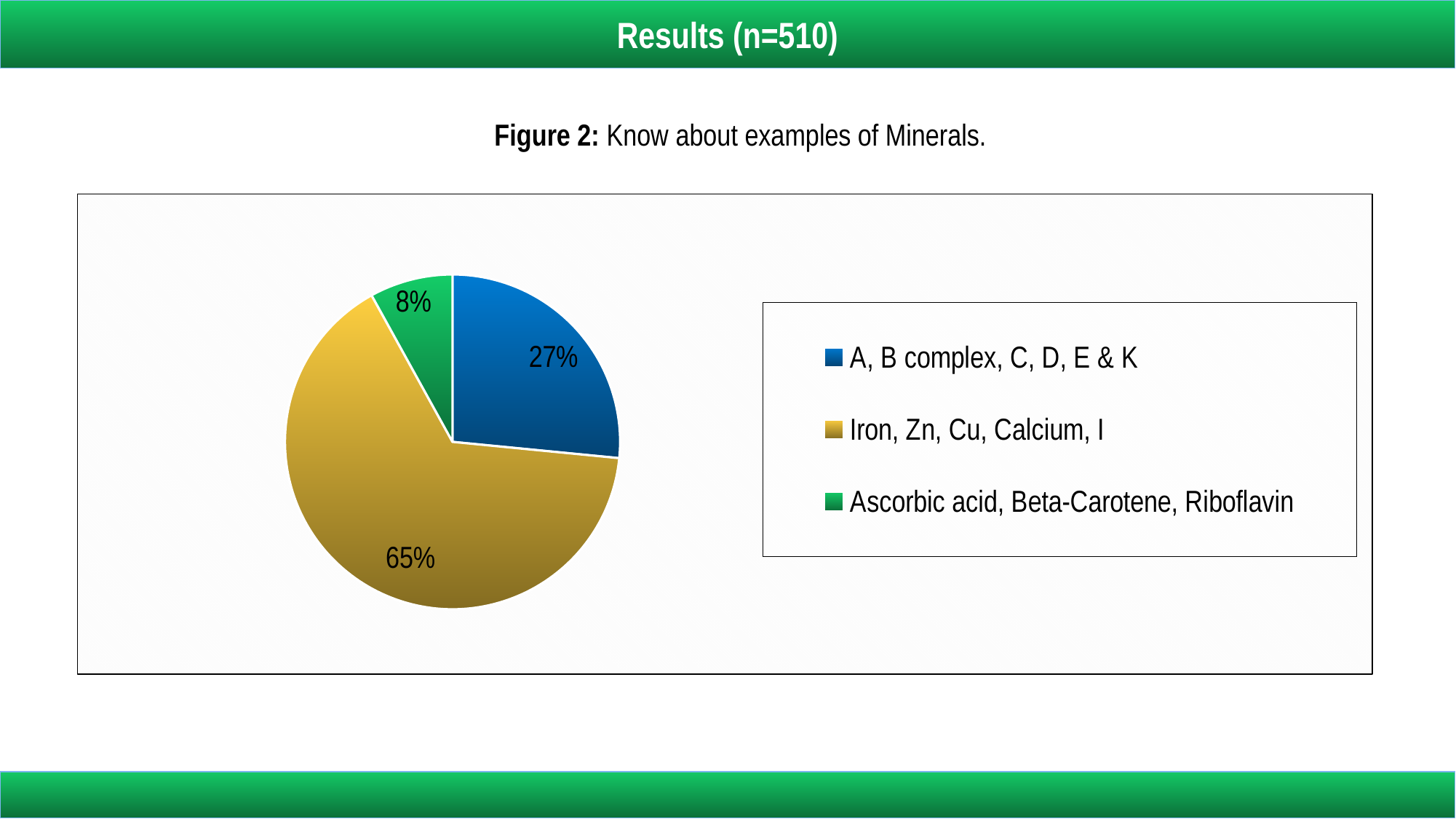
What colour is the slice for "Iron, Zn, Cu, Calcium, I"? Yellow/gold Which category has the smallest slice of the pie? Ascorbic acid, Beta-Carotene, Riboflavin Which category has the largest slice of the pie? Iron, Zn, Cu, Calcium, I What percentage of the pie is labelled for "Iron, Zn, Cu, Calcium, I"? 65% How many entries does the legend list? 3 What is the figure caption above the chart? Figure 2: Know about examples of Minerals. Which slice is larger: "A, B complex, C, D, E & K" or "Ascorbic acid, Beta-Carotene, Riboflavin"? A, B complex, C, D, E & K How many slices does the pie chart have? 3 What percentage of the pie is labelled for "A, B complex, C, D, E & K"? 27% What percentage of the pie is labelled for "Ascorbic acid, Beta-Carotene, Riboflavin"? 8% What is the difference in percentage points between the "Iron, Zn, Cu, Calcium, I" slice and the "A, B complex, C, D, E & K" slice? 38 What kind of chart is shown on the slide? Pie chart